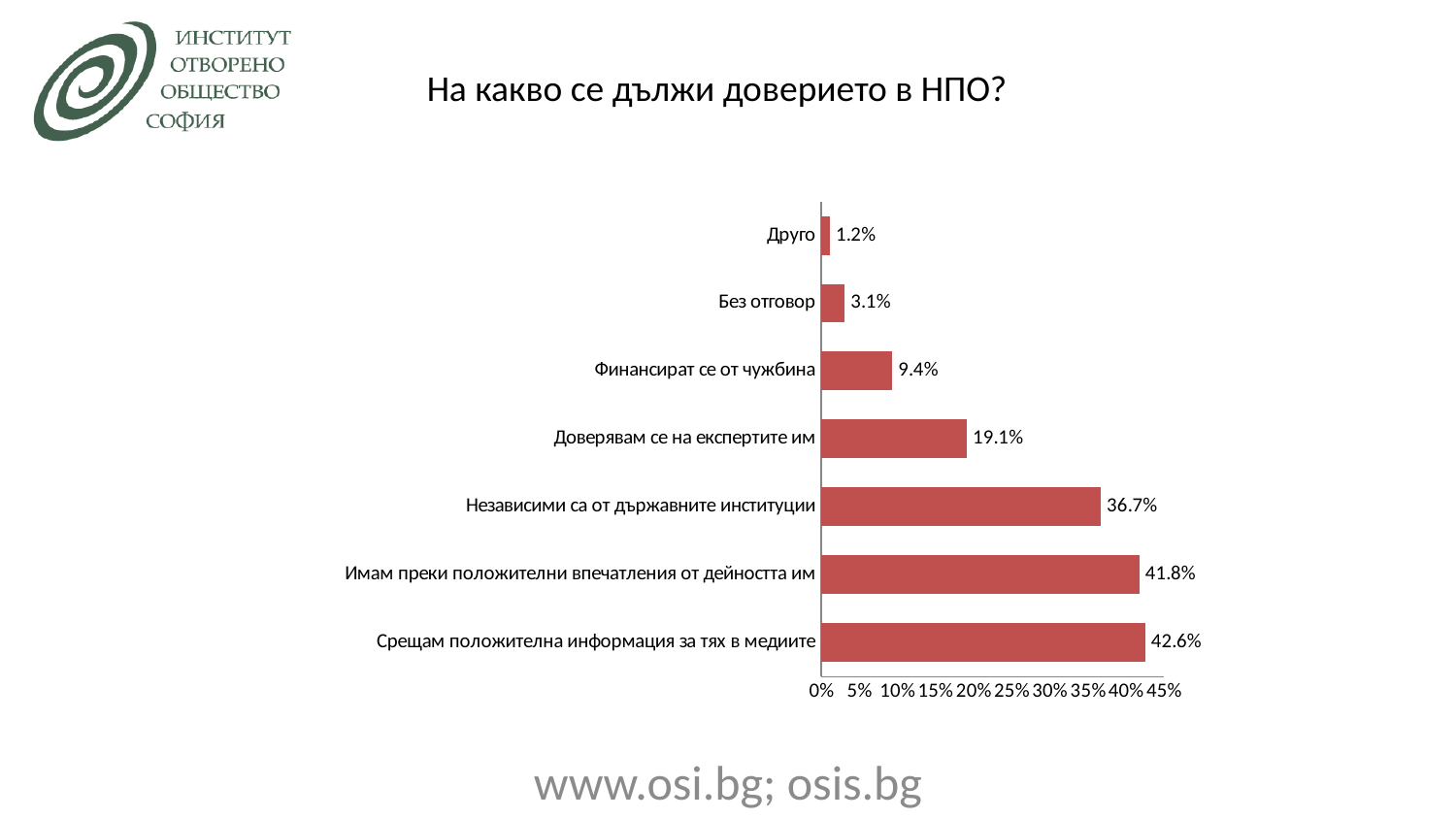
What is the title of the chart? На какво се дължи доверието в НПО? How many categories are shown in the chart? 7 What is the value for "Доверявам се на експертите им"? 19.1% Which is larger: "Без отговор" or "Друго"? Без отговор Which category has the highest value? Срещам положителна информация за тях в медиите Which category has the lowest value? Друго What is the maximum value shown on the horizontal axis? 45% What kind of chart is shown on the slide? Bar chart What is the value for "Срещам положителна информация за тях в медиите"? 42.6% What is the difference between "Имам преки положителни впечатления от дейността им" and "Независими са от държавните институции"? 5.1% Is the value for "Независими са от държавните институции" greater or less than 35%? greater What is the value for "Финансират се от чужбина"? 9.4%